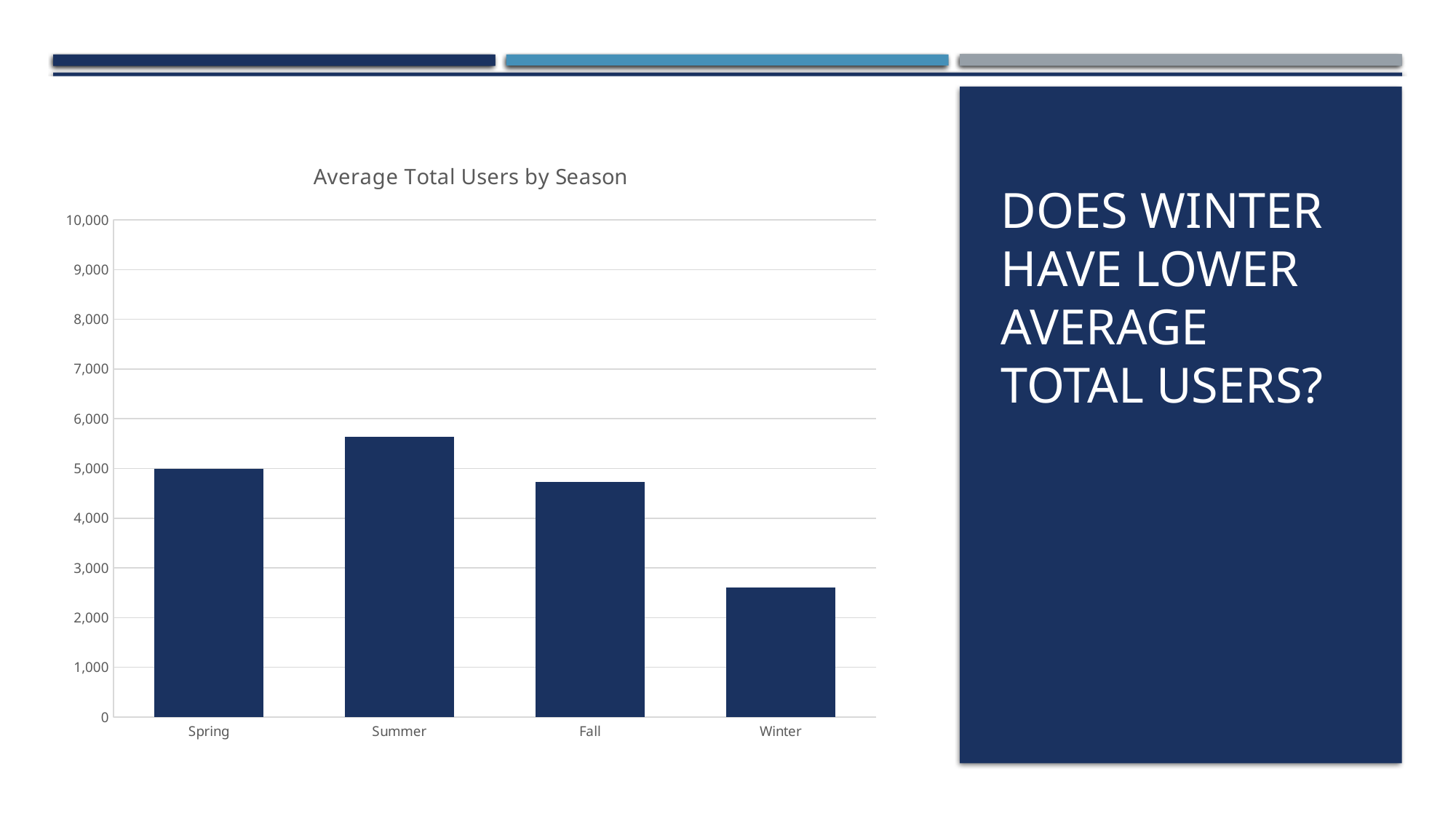
Which season has the lowest average total users? Winter How many seasons are plotted in the chart? 4 Which season has the highest average total users? Summer What type of chart is shown on the slide? bar chart Is the value for Summer greater or less than 6,000? less Which has more average total users, Spring or Winter? Spring Which has more average total users, Summer or Fall? Summer Is the value for Fall greater or less than 4,000? greater Is the value for Summer greater or less than 5,000? greater What is the title of the chart? Average Total Users by Season Do the values rise or fall from Fall to Winter? fall